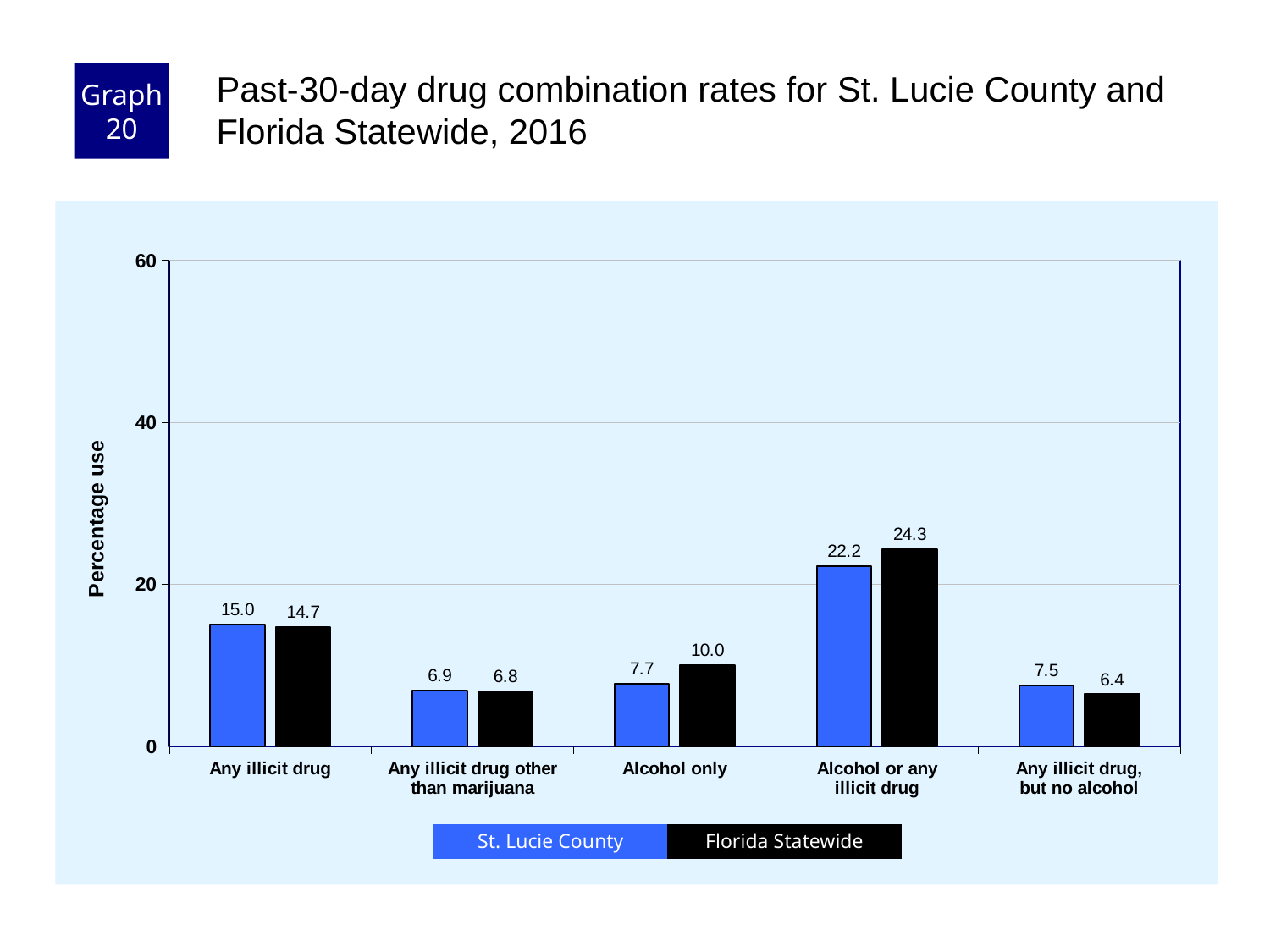
What is the difference between the Florida Statewide and St. Lucie County values for Alcohol or any illicit drug? 2.1 What is the Florida Statewide value for Alcohol only? 10.0 What kind of chart is shown on the slide? Bar chart Which category has the highest Florida Statewide value? Alcohol or any illicit drug What is the difference between the Florida Statewide and St. Lucie County values for Alcohol only? 2.3 Is the St. Lucie County value for Alcohol or any illicit drug greater or less than 20? greater How many series does the legend list? 2 What is the St. Lucie County value for Any illicit drug? 15.0 For Any illicit drug, but no alcohol, which is larger: St. Lucie County or Florida Statewide? St. Lucie County Which category has the lowest St. Lucie County value? Any illicit drug other than marijuana What is the Florida Statewide value for Any illicit drug, but no alcohol? 6.4 How many categories are shown on the x axis? 5